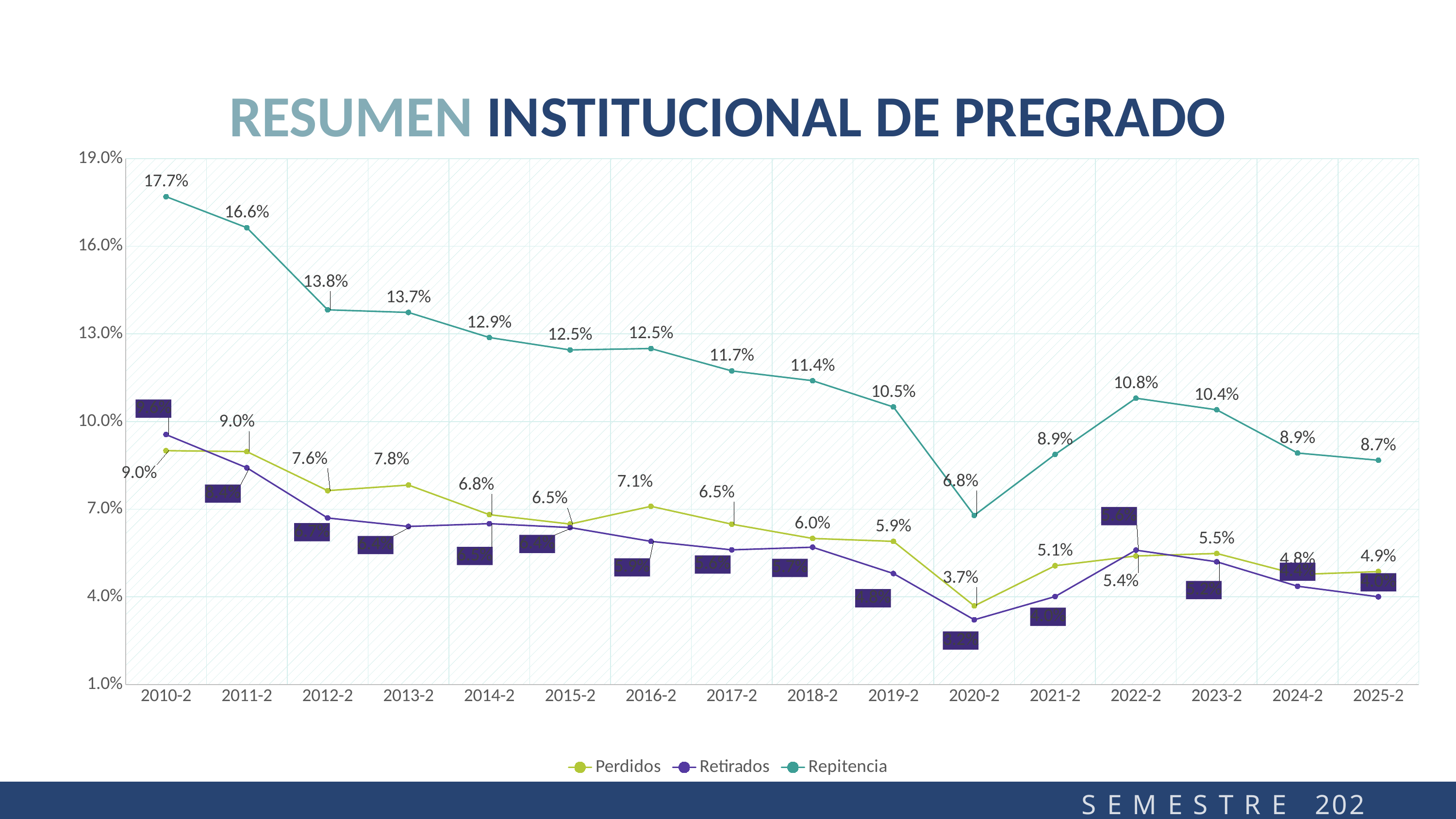
How many periods are shown on the x axis? 16 What is the Repitencia value for 2022-2? 10.8% Which is larger in 2015-2, the Repitencia value or the Perdidos value? Repitencia How many series does the legend list? 3 In which period is the Repitencia series at its lowest? 2020-2 Is the Retirados value for 2020-2 greater or less than 4.0%? less What is the difference between the Repitencia values for 2010-2 and 2025-2? 9.0 percentage points What is the Perdidos value for 2020-2? 3.7% In which period is the Repitencia series at its highest? 2010-2 What kind of chart is shown on the slide? line chart Does the Repitencia series rise or fall from 2010-2 to 2019-2? fall What is the Repitencia value for 2010-2? 17.7%